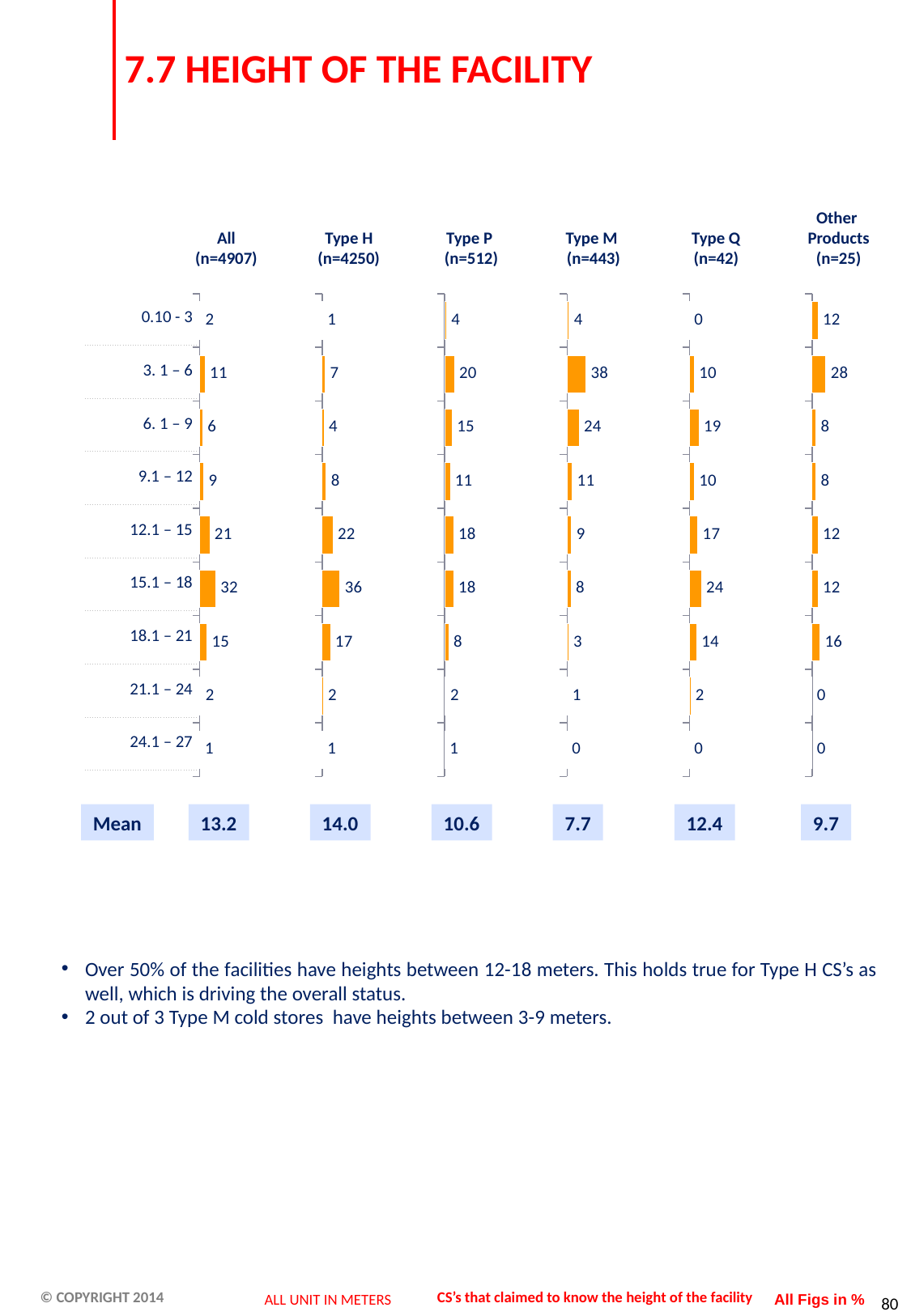
In the Type H (n=4250) chart, what is the value for the 12.1 – 15 height range? 22 What kind of chart is used for the Type H (n=4250) data? Bar chart In the Type P (n=512) chart, what is the difference between the values for 3. 1 – 6 and 6. 1 – 9? 5 How many height-range categories are shown in the All (n=4907) chart? 9 In the Type H (n=4250) chart, which height range has the highest value? 15.1 – 18 In the Other Products (n=25) chart, what is the value for the 3. 1 – 6 height range? 28 What is the Mean value shown for Type M? 7.7 In the Type M (n=443) chart, which height range has the highest value? 3. 1 – 6 In the Type Q (n=42) chart, which is larger: the value for 15.1 – 18 or the value for 6. 1 – 9? 15.1 – 18 Which group has the highest Mean value shown below the charts? Type H In the All (n=4907) chart, what is the value for the 15.1 – 18 height range? 32 In the Type M (n=443) chart, what is the difference between the values for 3. 1 – 6 and 6. 1 – 9? 14